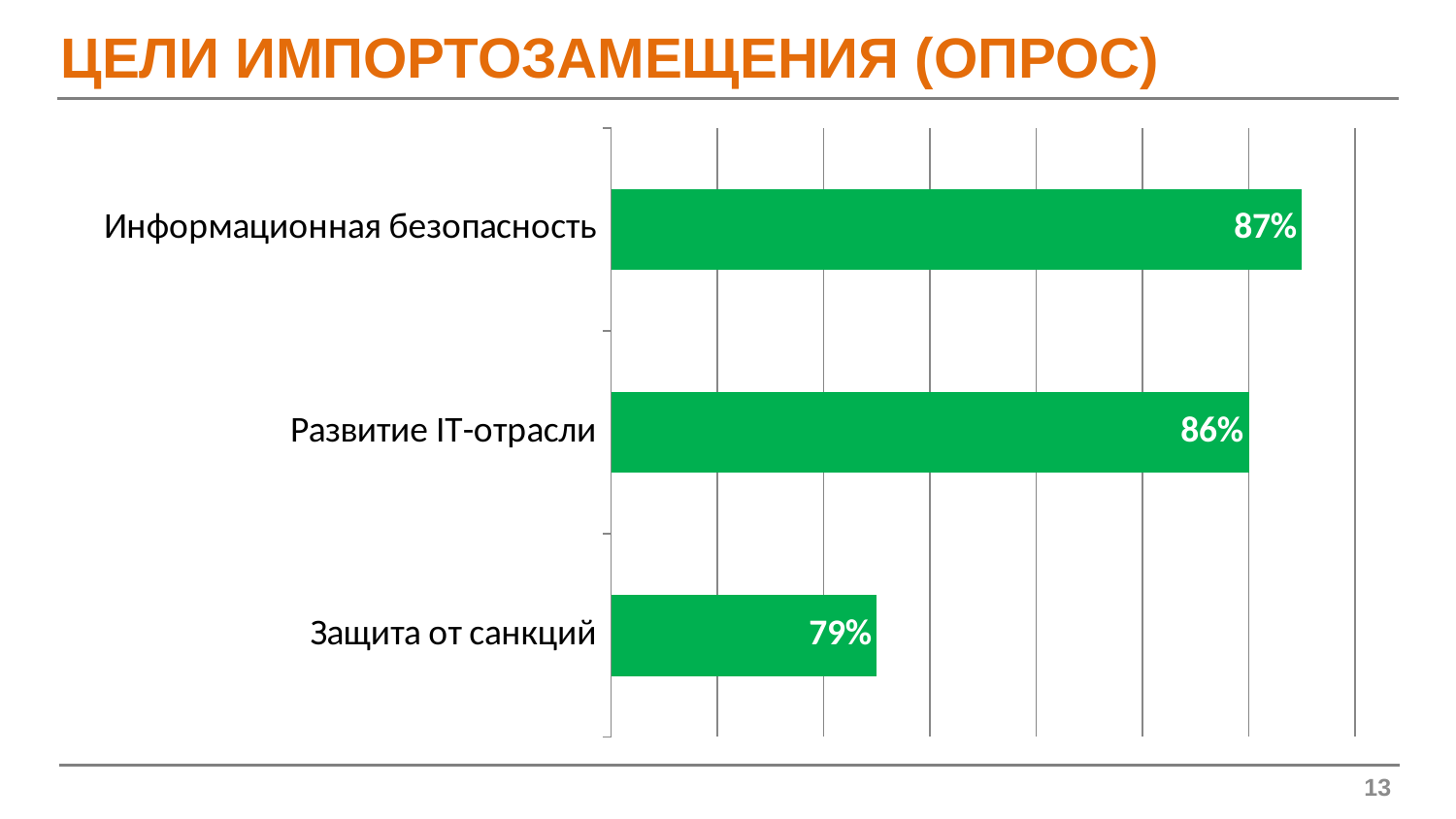
What is the difference between the values for Развитие IT-отрасли and Защита от санкций? 7% What is the value for Защита от санкций? 79% Which is larger, the value for Развитие IT-отрасли or the value for Защита от санкций? Развитие IT-отрасли How many categories are shown in the chart? 3 What is the value for Информационная безопасность? 87% Which category has the lowest value? Защита от санкций What is the value for Развитие IT-отрасли? 86% Which category has the highest value? Информационная безопасность What is the difference between the values for Информационная безопасность and Защита от санкций? 8% What is the title of the slide containing the chart? ЦЕЛИ ИМПОРТОЗАМЕЩЕНИЯ (ОПРОС) What kind of chart is shown on the slide? bar chart What colour are the bars in the chart? green